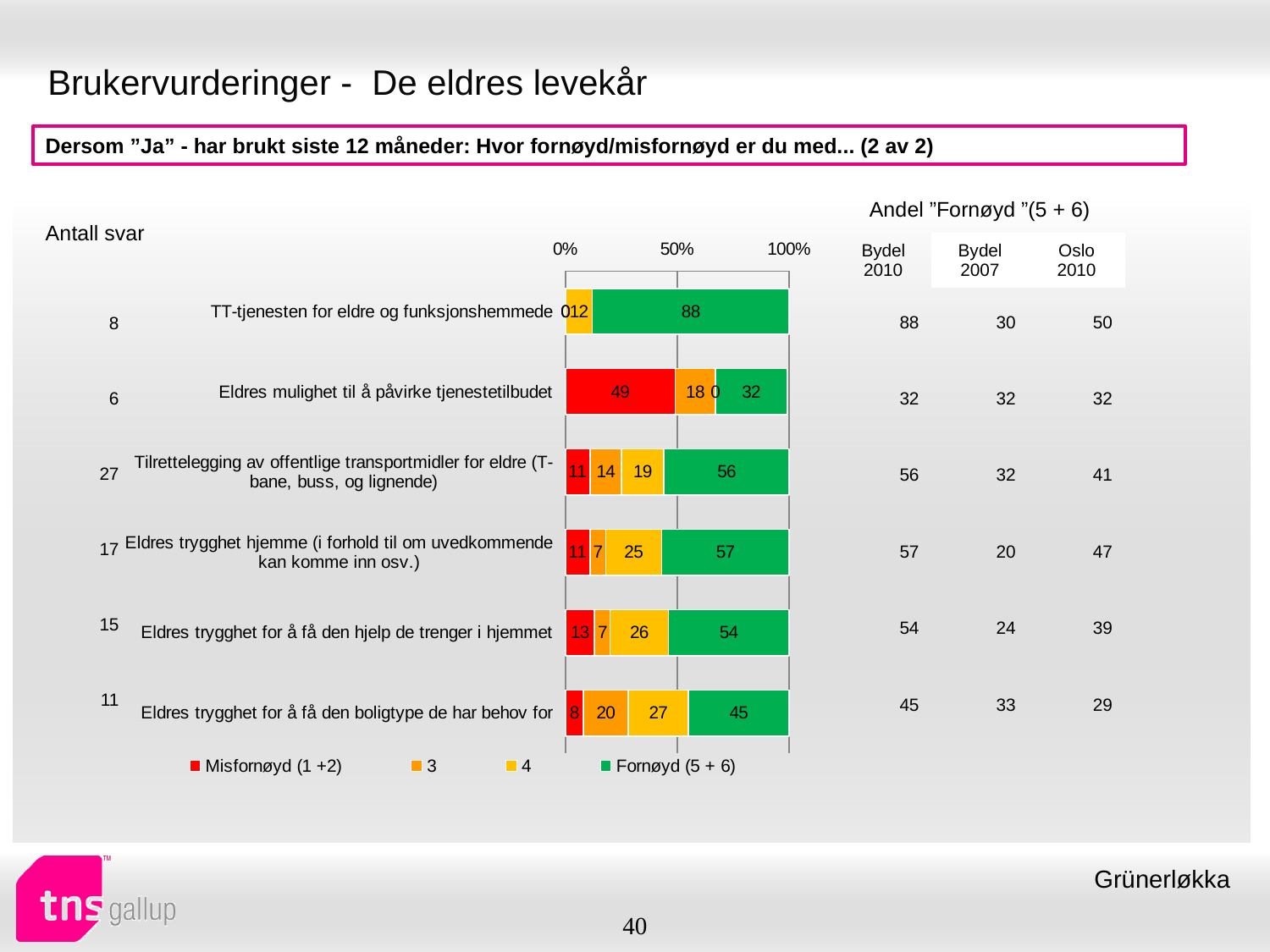
What is the Fornøyd (5 + 6) value for "TT-tjenesten for eldre og funksjonshemmede"? 88 What kind of chart is shown on the slide? Stacked bar chart Which category has the highest Fornøyd (5 + 6) value? TT-tjenesten for eldre og funksjonshemmede Which category has the lowest Fornøyd (5 + 6) value? Eldres mulighet til å påvirke tjenestetilbudet What is the total of the stacked bar for "Eldres trygghet hjemme (i forhold til om uvedkommende kan komme inn osv.)"? 100 How many series does the legend list? 4 How many categories are shown in the chart? 6 What is the Misfornøyd (1 +2) value for "Eldres mulighet til å påvirke tjenestetilbudet"? 49 What is the first entry in the chart legend? Misfornøyd (1 +2) What is the difference between the Fornøyd (5 + 6) values for "Tilrettelegging av offentlige transportmidler for eldre" and "Eldres trygghet for å få den boligtype de har behov for"? 11 What is the value of series "4" for "Eldres trygghet for å få den boligtype de har behov for"? 27 Which is larger: the Misfornøyd (1 +2) value for "Eldres trygghet for å få den hjelp de trenger i hjemmet" or for "Eldres trygghet for å få den boligtype de har behov for"? Eldres trygghet for å få den hjelp de trenger i hjemmet